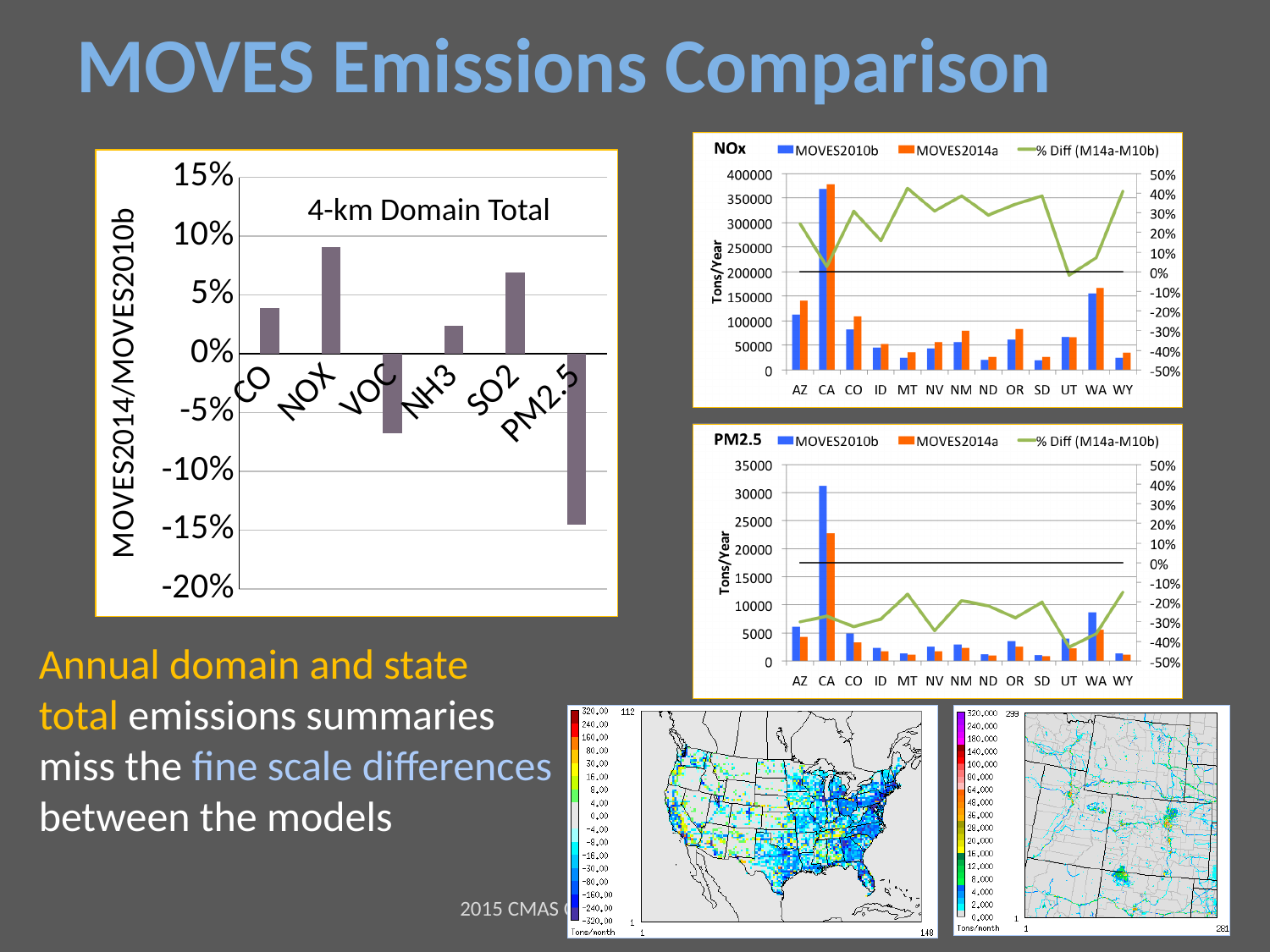
In the 4-km Domain Total chart, which pollutant has the lowest MOVES2014/MOVES2010b value? PM2.5 In the NOx chart, is the MOVES2010b value for CA greater or less than 350000? greater What kind of chart is the 4-km Domain Total chart? bar chart In the PM2.5 chart, which is larger for CA, MOVES2010b or MOVES2014a? MOVES2010b In the PM2.5 chart, is the MOVES2010b value for CA greater or less than 30000? greater In the PM2.5 chart, how many states are shown on the x axis? 13 In the 4-km Domain Total chart, is the value for PM2.5 greater or less than -10%? less In the 4-km Domain Total chart, which pollutant has the highest MOVES2014/MOVES2010b value? NOX In the 4-km Domain Total chart, how many pollutant categories are shown on the x axis? 6 In the NOx chart, which state has the highest MOVES2014a emissions? CA In the NOx chart, how many series does the legend list? 3